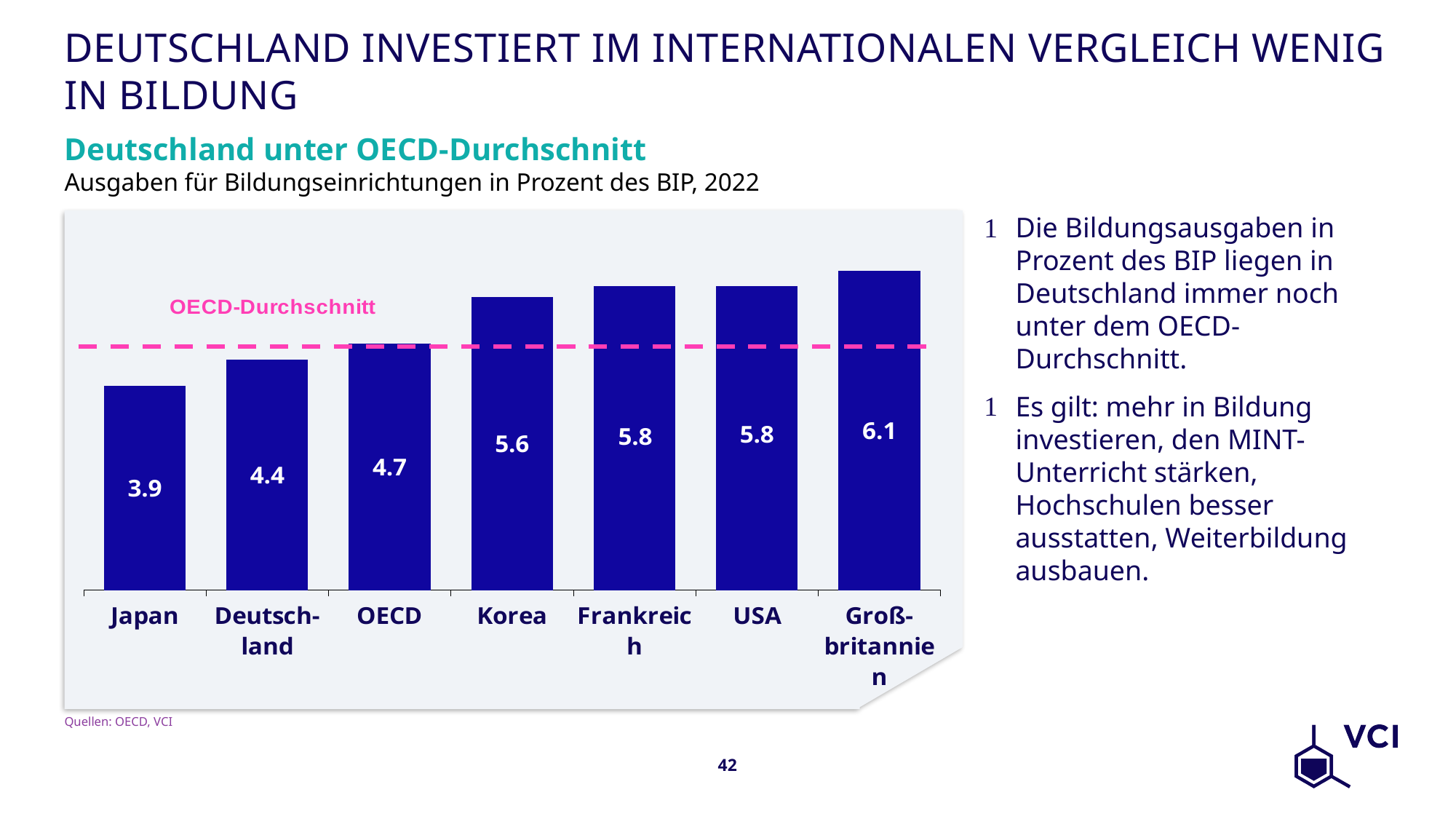
What is the difference between the values for Großbritannien and Deutschland? 1.7 What does the pink dashed line in the chart represent? OECD-Durchschnitt What is the value for Großbritannien? 6.1 What is the value for Japan? 3.9 What kind of chart is shown on the slide? Bar chart Which is larger, the value for Korea or the value for Deutschland? Korea Which category has the lowest value? Japan How many bars are shown in the chart? 7 What is the difference between the OECD value and the value for Japan? 0.8 Which category has the highest value? Großbritannien What is the value for Deutschland? 4.4 What is the value for Korea? 5.6